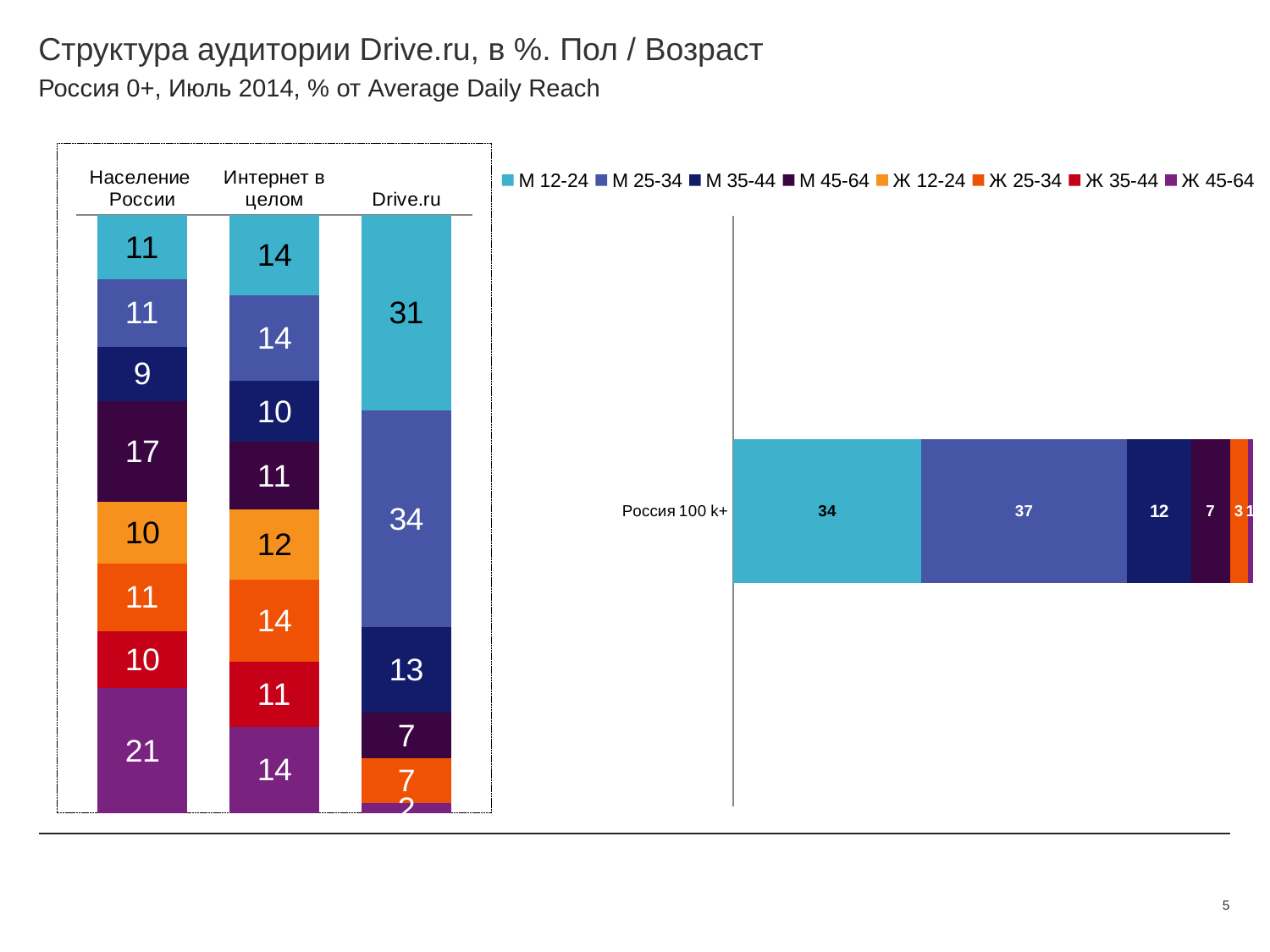
In the left stacked bar chart, what is the value for М 25-34 in the Drive.ru bar? 34 How many bars (categories) are shown in the left stacked bar chart? 3 What kind of chart is the right chart (Россия 100 k+)? Stacked bar chart In the right chart (Россия 100 k+), what is the value for М 25-34? 37 In the left stacked bar chart, what is the total of the Население России stacked bar? 100 In the right chart (Россия 100 k+), what is the value for М 35-44? 12 In the left stacked bar chart, which has the larger М 12-24 value: Drive.ru or Интернет в целом? Drive.ru In the left stacked bar chart, which segment is the largest in the Население России bar? Ж 45-64 In the left stacked bar chart, what is the difference between the М 25-34 value for Drive.ru and the М 25-34 value for Население России? 23 In the left stacked bar chart, what is the value for М 35-44 in the Интернет в целом bar? 10 In the left stacked bar chart, what is the value for Ж 45-64 in the Население России bar? 21 How many series does the legend list? 8